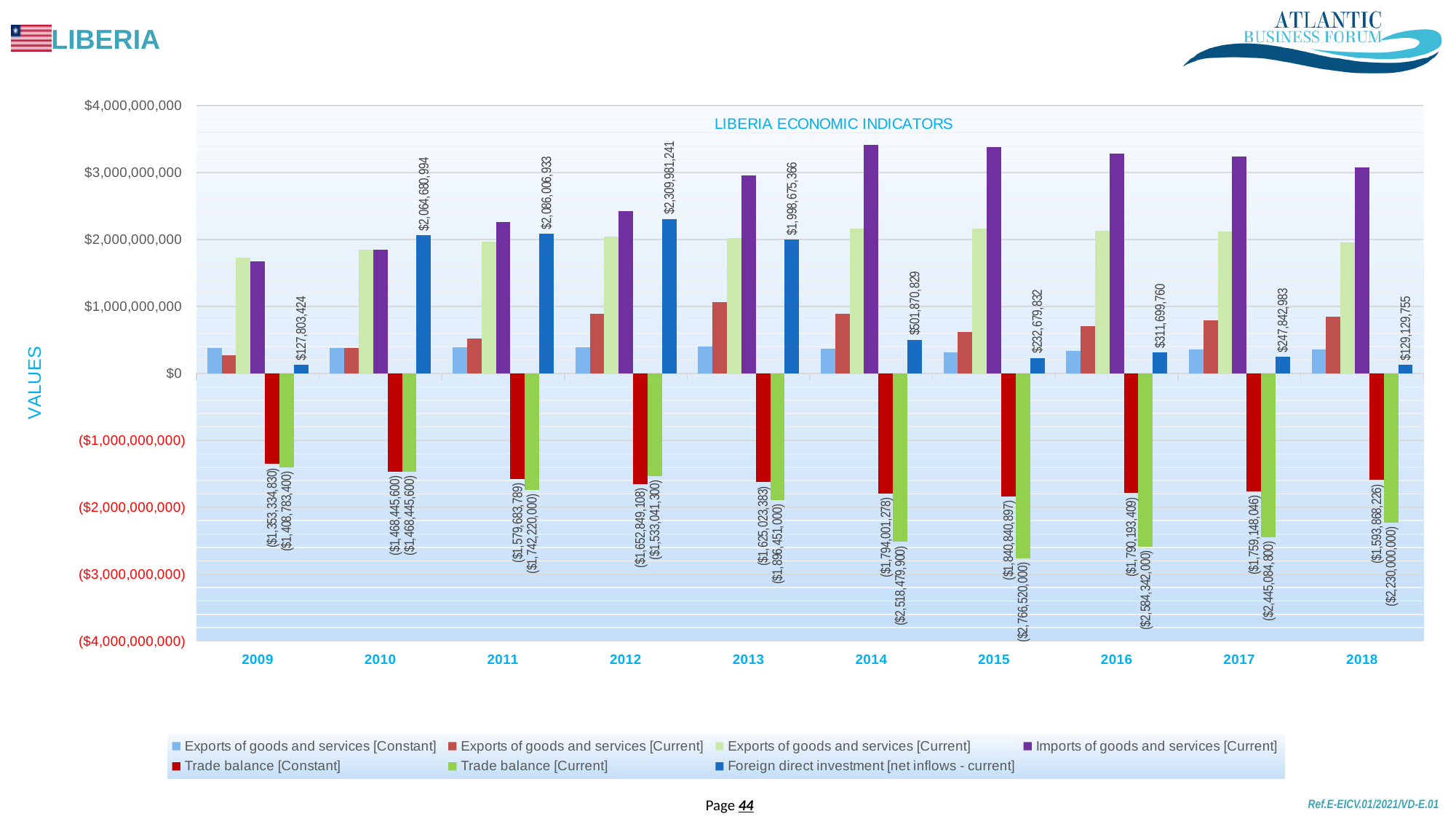
What kind of chart is shown on the slide? bar chart In which year is the Trade balance [Current] most negative (lowest)? 2015 Which is larger: Foreign direct investment [net inflows - current] in 2014 or in 2016? 2014 What is the difference between Foreign direct investment [net inflows - current] in 2012 and in 2011? $223,974,308 Is the value for Imports of goods and services [Current] in 2014 greater or less than $3,000,000,000? greater How many years are shown on the x axis? 10 What is the Trade balance [Current] value for 2018? ($2,230,000,000) What is the Trade balance [Constant] value for 2015? ($1,840,840,897) How many series does the legend list? 7 What is the title of the chart? LIBERIA ECONOMIC INDICATORS What is the value of Foreign direct investment [net inflows - current] for 2012? $2,309,981,241 In which year is Foreign direct investment [net inflows - current] highest? 2012